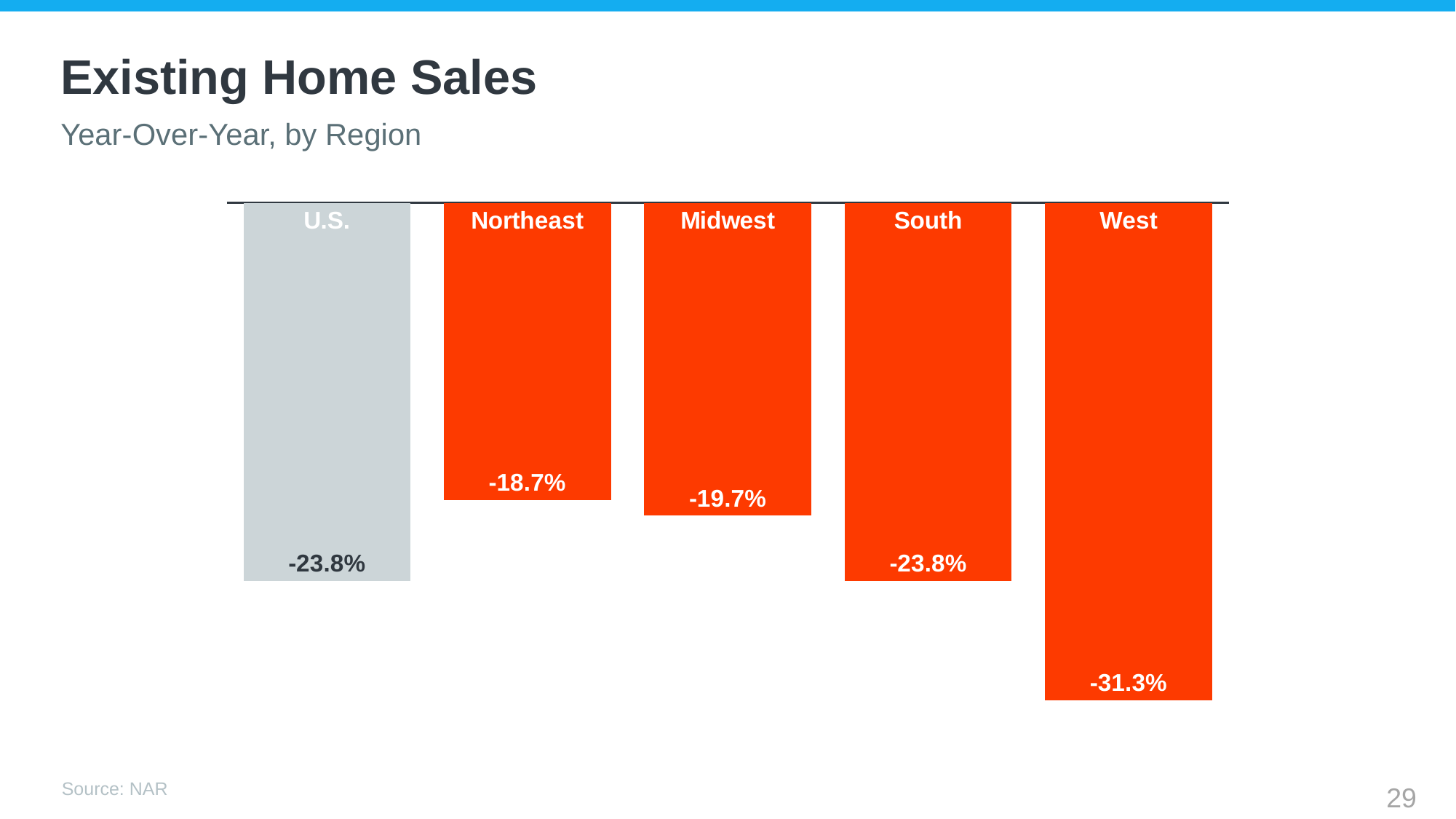
Which region shows the largest year-over-year decline in existing home sales? West How many bars are shown in the chart? 5 What is the year-over-year change in existing home sales for the U.S.? -23.8% What is the year-over-year change in existing home sales for the West? -31.3% Which region had a larger year-over-year decline, the Midwest or the South? South What is the year-over-year change in existing home sales for the Northeast? -18.7% What type of chart is shown on the slide? Bar chart What is the year-over-year change in existing home sales for the Midwest? -19.7% Which region shows the smallest year-over-year decline in existing home sales? Northeast What is the year-over-year change in existing home sales for the South? -23.8% What is the difference between the West's and the Northeast's year-over-year change? 12.6 percentage points Which bar is shown in a different colour (grey) from the others? U.S.